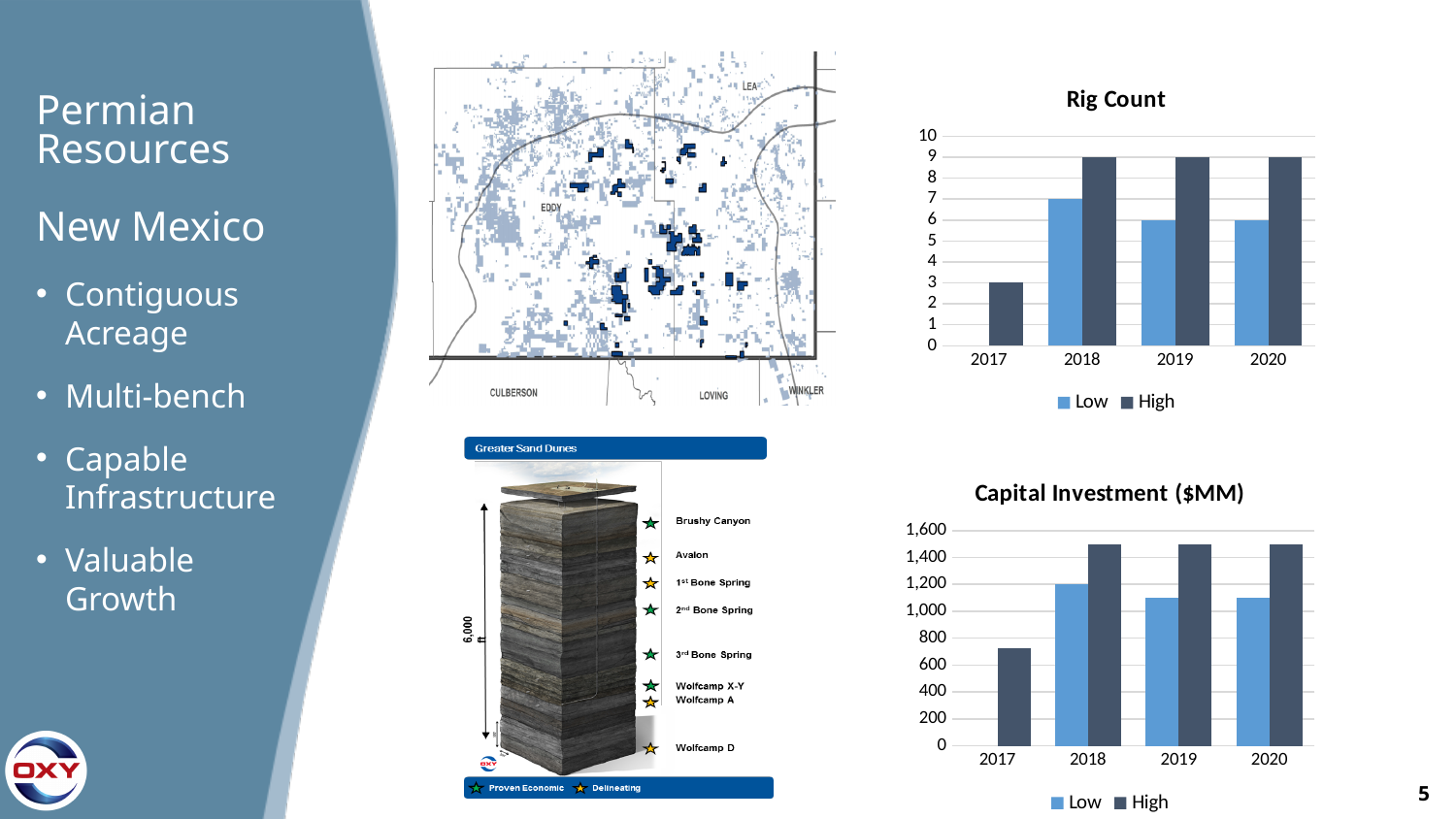
In the Rig Count chart, is the Low value for 2018 larger or smaller than the Low value for 2020? larger In the Rig Count chart, what is the High value for 2018? 9 In the Rig Count chart, what is the difference between the High and Low values for 2018? 2 What type of chart is the Capital Investment ($MM) chart? bar chart In the Capital Investment ($MM) chart, is the High value for 2017 greater or less than 800? less In the Rig Count chart, what is the High value for 2017? 3 In the Rig Count chart, which year has the lowest High value? 2017 In the Rig Count chart, what is the Low value for 2019? 6 In the Capital Investment ($MM) chart, what is the Low value for 2018? 1,200 How many years are shown on the x axis of the Rig Count chart? 4 How many series does the legend of the Capital Investment ($MM) chart list? 2 In the Capital Investment ($MM) chart, is the High value for 2019 greater or less than 1,400? greater